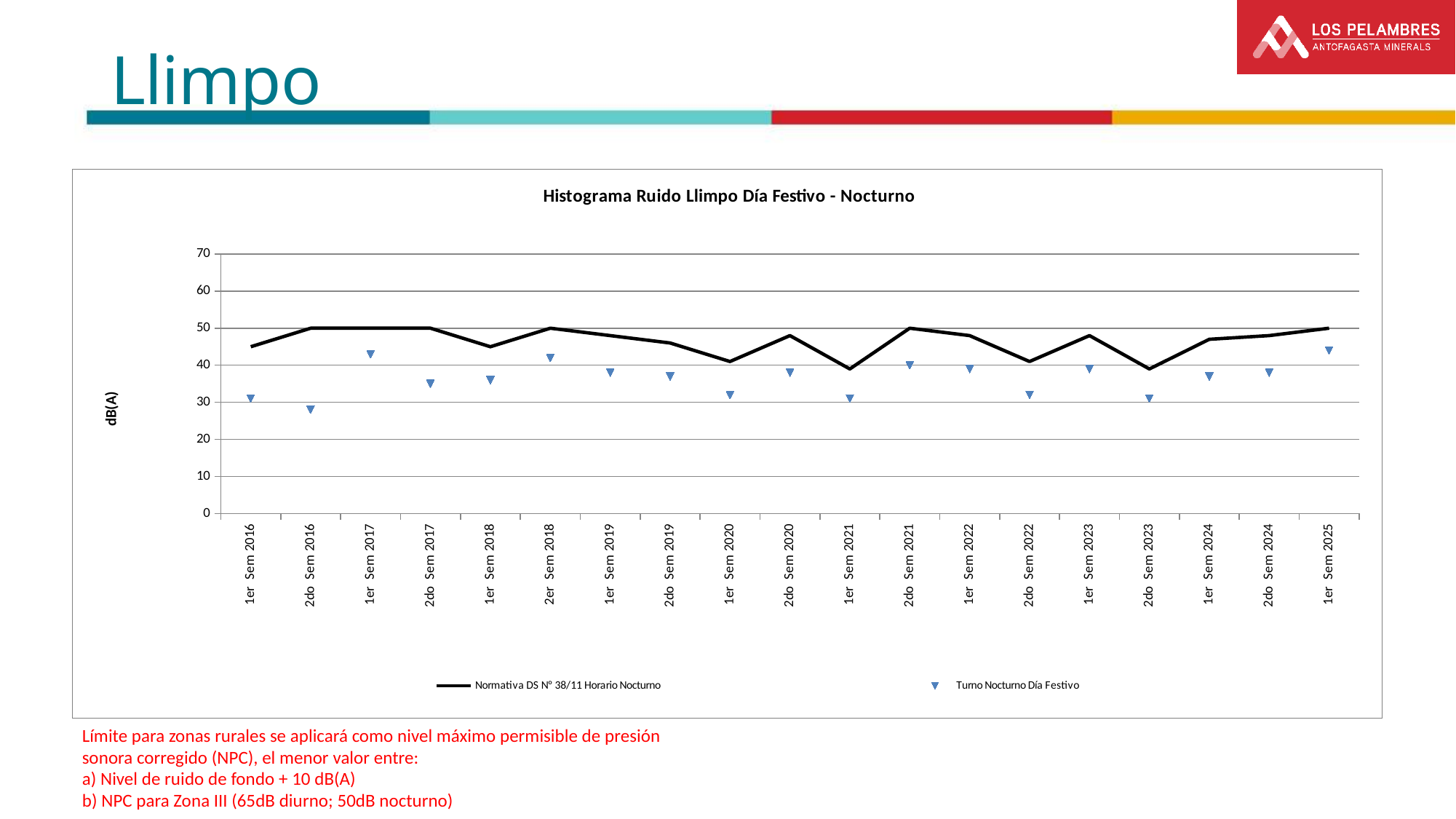
Is the Turno Nocturno Día Festivo value for 2do Sem 2016 greater or less than 30? less How many semester categories are shown on the x axis? 19 What is the label of the vertical axis? dB(A) Which semester has the lowest Turno Nocturno Día Festivo value? 2do Sem 2016 Is the Turno Nocturno Día Festivo value for 2do Sem 2020 greater or less than 40? less What is the value of the Normativa DS N° 38/11 Horario Nocturno line at 2do Sem 2017? 50 What kind of chart is shown on the slide? line chart What is the title of the chart? Histograma Ruido Llimpo Día Festivo - Nocturno What is the value of the Normativa DS N° 38/11 Horario Nocturno line at 1er Sem 2025? 50 How many series does the chart legend list? 2 Which is larger, the Turno Nocturno Día Festivo value for 1er Sem 2017 or for 2do Sem 2017? 1er Sem 2017 Is the Turno Nocturno Día Festivo value for 1er Sem 2017 greater or less than 40? greater